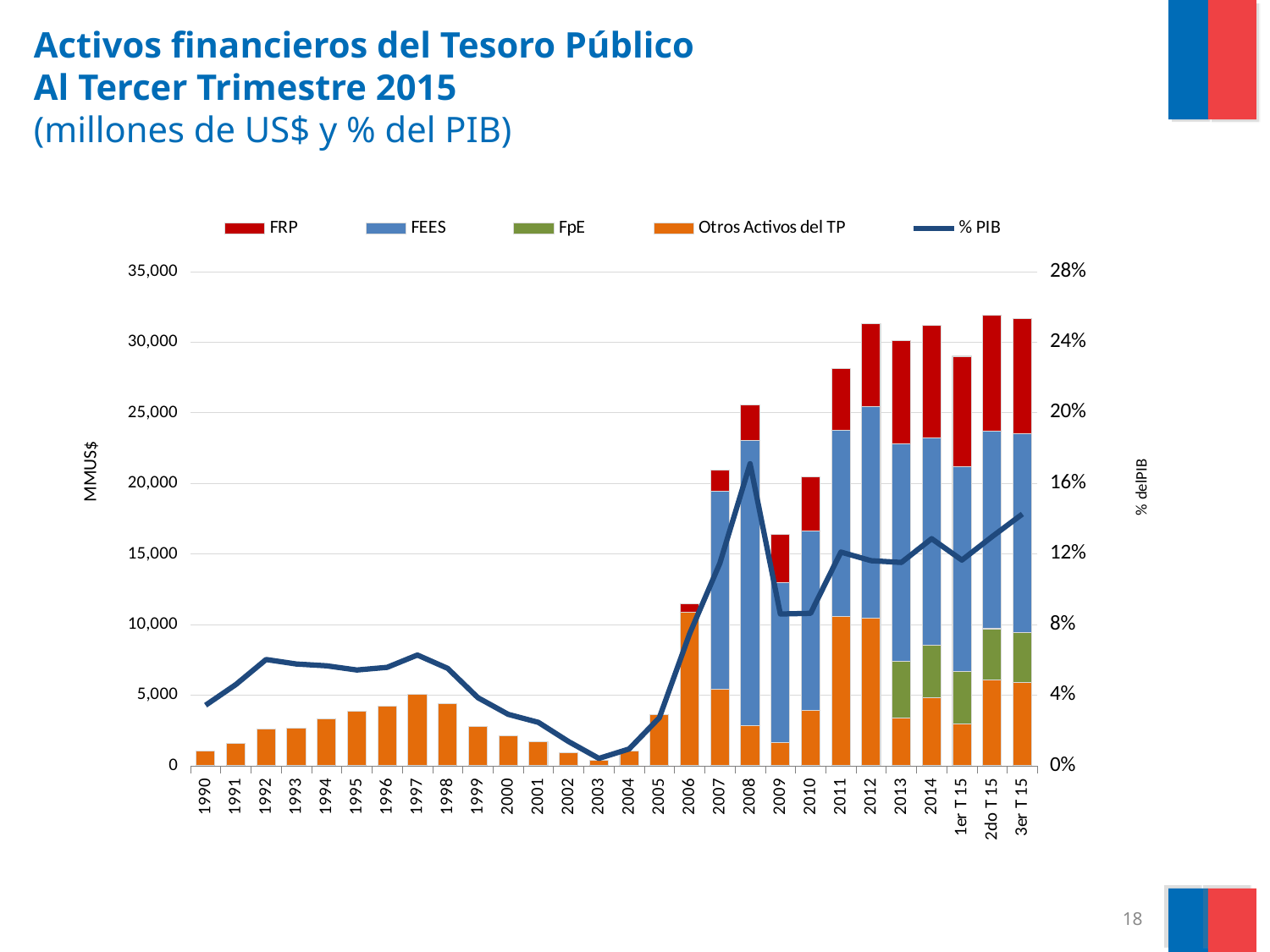
Is the total stacked bar for 2012 greater or less than 30,000? greater What is the label of the left vertical axis? MMUS$ Do the total stacked bars rise or fall from 2003 to 2008? rise In which year does the % PIB line reach its highest point? 2008 Which has the larger total stacked bar, 2008 or 2009? 2008 Which year has the lowest total stacked bar? 2003 Is the % PIB value for 3er T 15 greater or less than 12%? greater What kind of chart is this? Stacked bar chart with a line How many series does the legend list? 5 Is the total stacked bar for 2009 greater or less than 20,000? less How many categories are shown on the x axis? 28